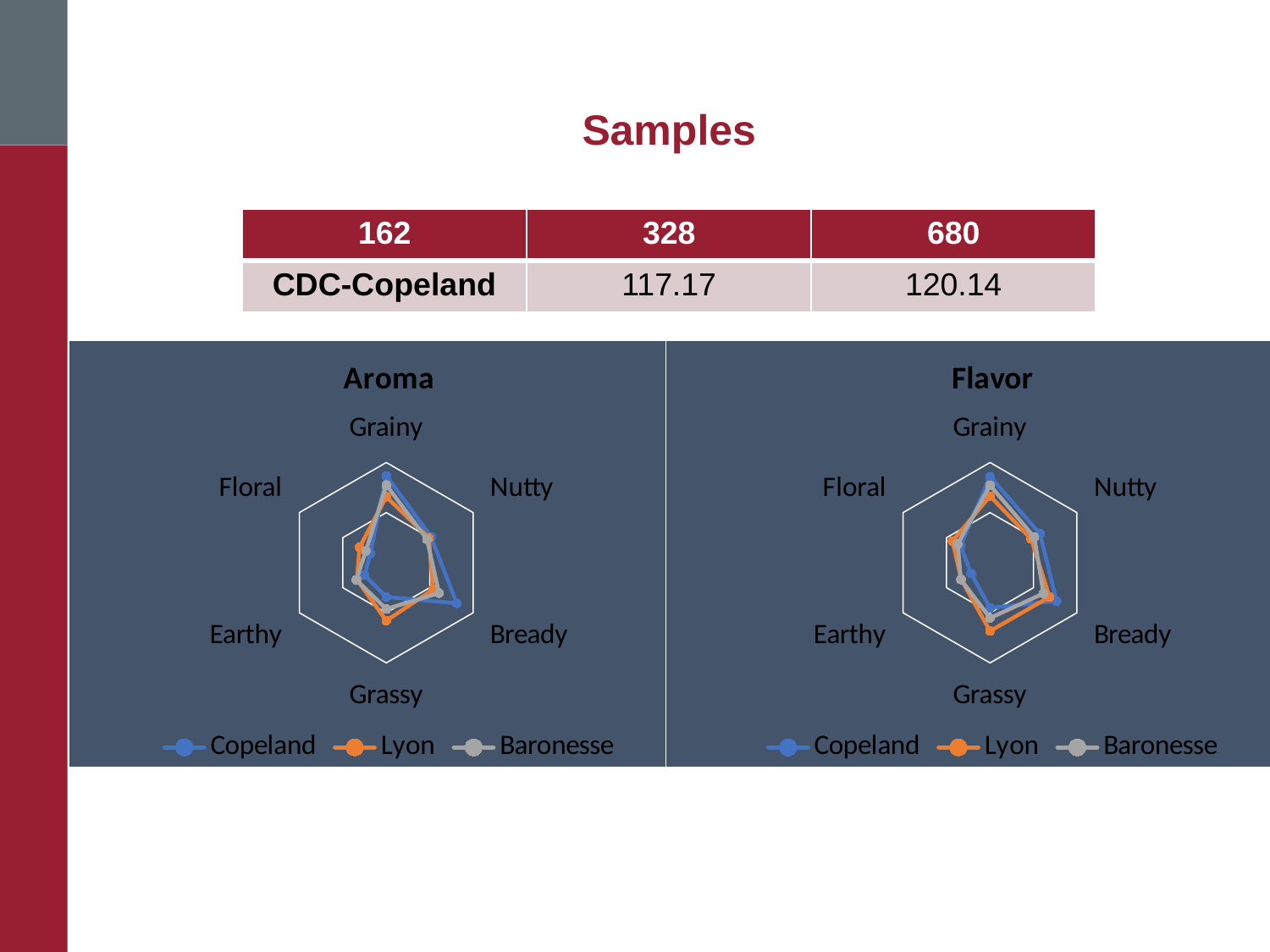
How many series does the legend of the Aroma chart list? 3 In the Aroma chart, which series has the larger value for Bready, Copeland or Lyon? Copeland What are the names of the series listed in the legend of the Flavor chart? Copeland, Lyon, Baronesse What kind of chart is the Aroma chart? radar chart How many categories (axes) does the Flavor chart have? 6 In the Aroma chart, which series has the larger value for Grassy, Lyon or Copeland? Lyon How many series does the legend of the Flavor chart list? 3 In the Flavor chart, which series has the larger value for Nutty, Copeland or Baronesse? Copeland What kind of chart is the Flavor chart? radar chart How many categories (axes) does the Aroma chart have? 6 What is the title of the chart on the left side of the slide? Aroma